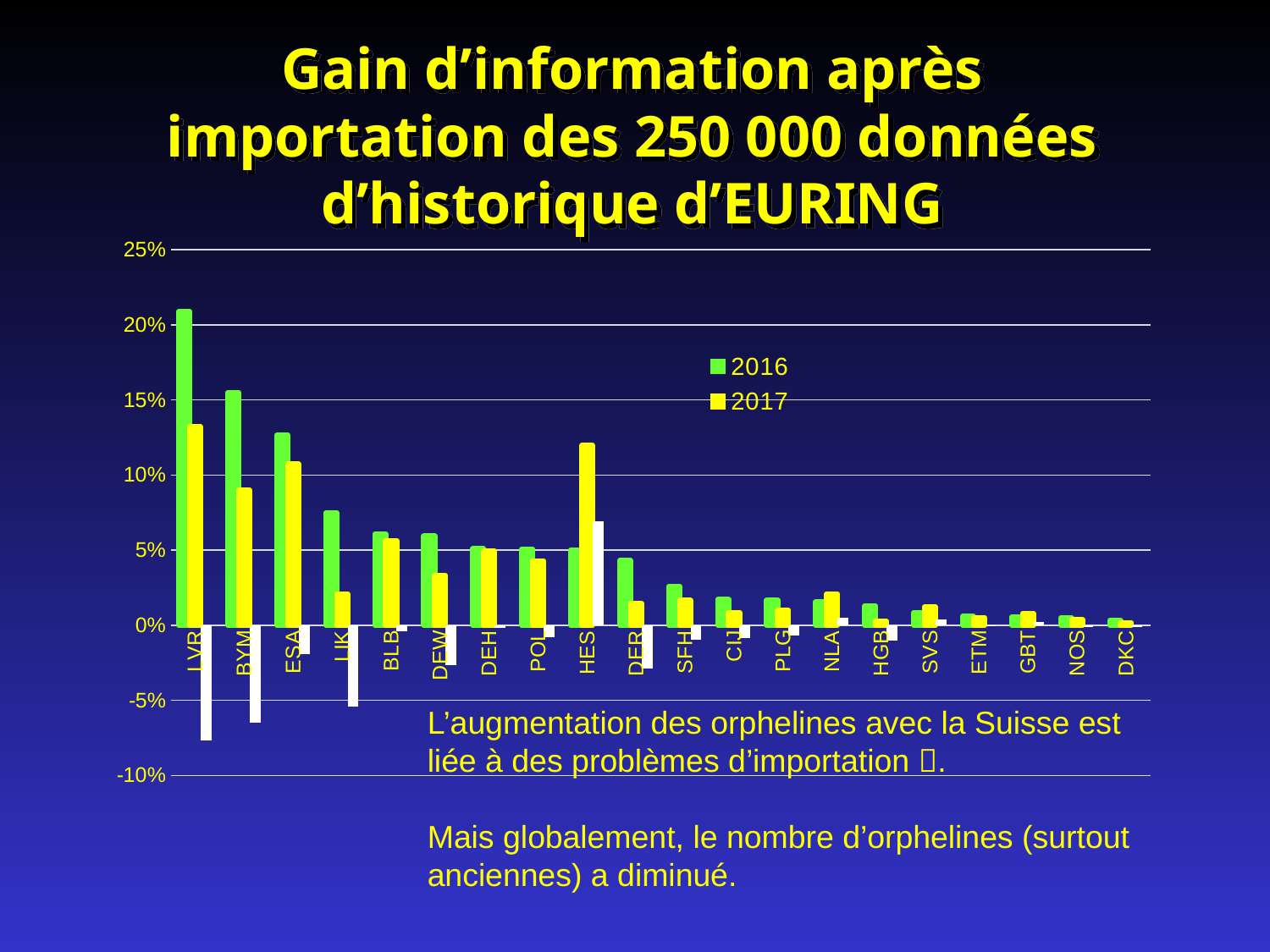
Which colour represents the 2017 series in the chart legend? yellow Is the 2017 value for DEW greater or less than 5%? less Which is larger, the 2017 value for HES or the 2017 value for DEH? HES Is the 2016 value for LVR greater or less than 20%? greater Do the 2016 values generally rise or fall from left to right along the x axis? fall Is the 2017 value for HES greater or less than 10%? greater Which category has the highest value for the 2016 series? LVR What kind of chart is shown on the slide? bar chart How many series does the chart legend list? 2 How many categories are shown along the x axis of the chart? 20